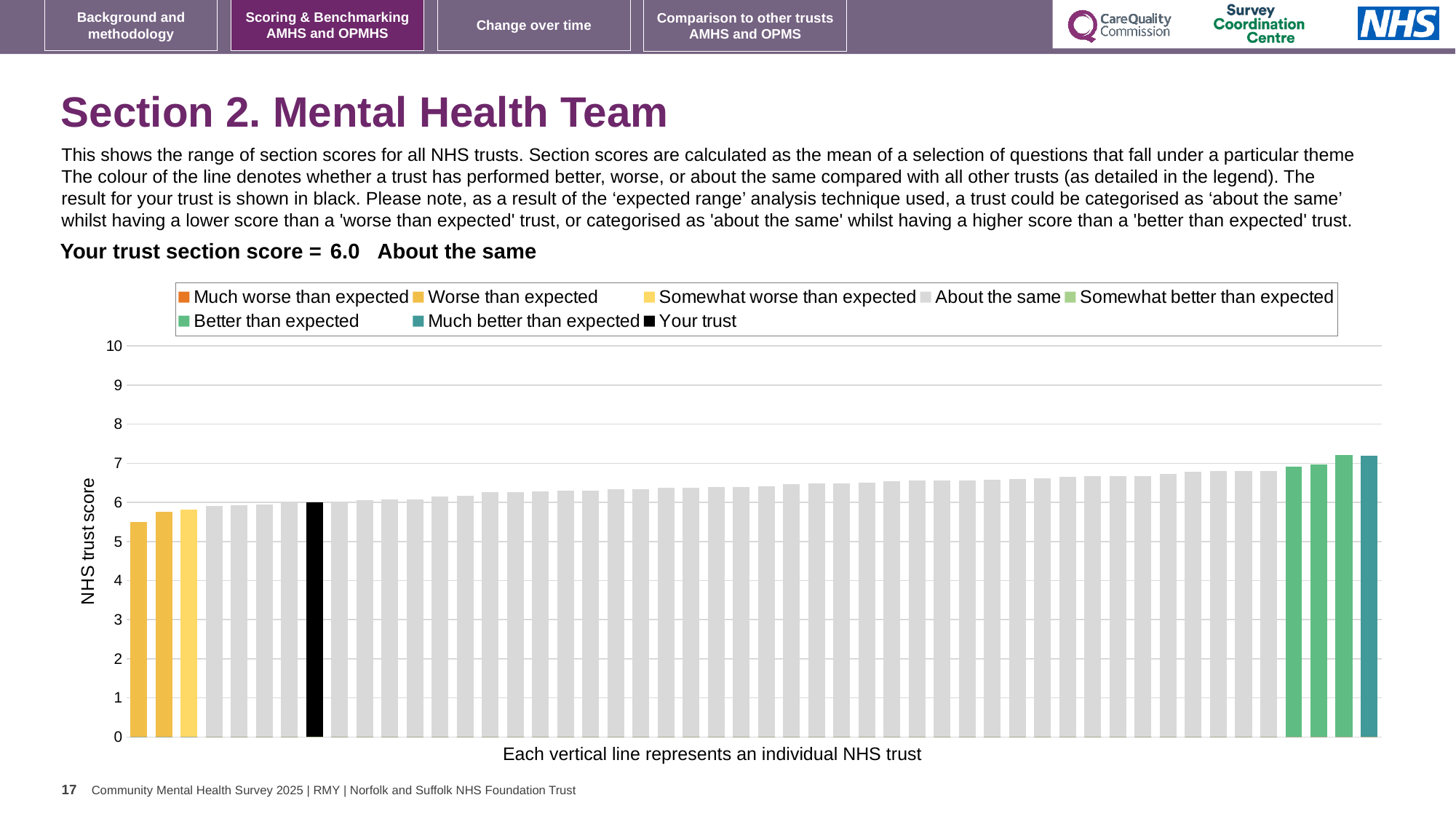
Which is larger, the leftmost bar or the rightmost bar? the rightmost bar What colour is the bar representing your trust? black What is the section score for your trust? 6.0 Is the value of the leftmost bar greater or less than 6? less Is the value of the rightmost bar greater or less than 6? greater How many entries does the chart legend list? 8 How many bars are coloured as 'Worse than expected'? 2 What kind of chart is shown on the slide? bar chart Which category is your trust placed in for this section? About the same What is the label on the y axis? NHS trust score Is the value of the black 'Your trust' bar greater or less than 5? greater Do the bar values rise or fall from left to right along the x axis? rise